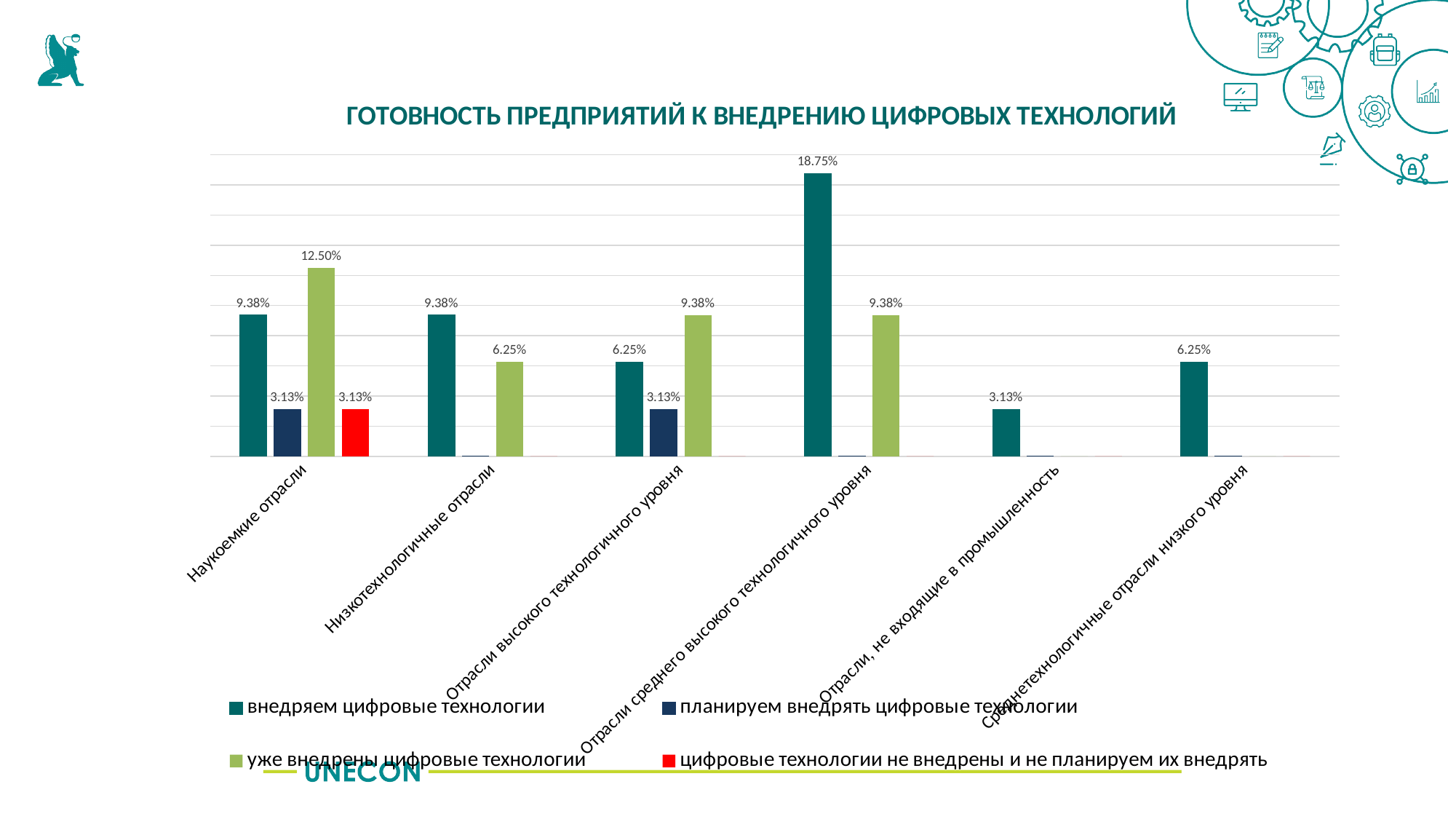
What is the value for 'внедряем цифровые технологии' in the category 'Отрасли среднего высокого технологичного уровня'? 18.75% How many categories are shown on the x axis? 6 How many series does the legend list? 4 What kind of chart is shown on the slide? Bar chart What is the title of the chart? ГОТОВНОСТЬ ПРЕДПРИЯТИЙ К ВНЕДРЕНИЮ ЦИФРОВЫХ ТЕХНОЛОГИЙ What is the value for 'уже внедрены цифровые технологии' in the category 'Низкотехнологичные отрасли'? 6.25% In the category 'Отрасли высокого технологичного уровня', which is larger: 'внедряем цифровые технологии' or 'уже внедрены цифровые технологии'? уже внедрены цифровые технологии What is the value for 'уже внедрены цифровые технологии' in the category 'Наукоемкие отрасли'? 12.50% Which category has the lowest value for 'внедряем цифровые технологии'? Отрасли, не входящие в промышленность What is the difference between the 'внедряем цифровые технологии' value for 'Отрасли среднего высокого технологичного уровня' and for 'Наукоемкие отрасли'? 9.37% Which category has the highest value for 'внедряем цифровые технологии'? Отрасли среднего высокого технологичного уровня What is the value for 'цифровые технологии не внедрены и не планируем их внедрять' in the category 'Наукоемкие отрасли'? 3.13%